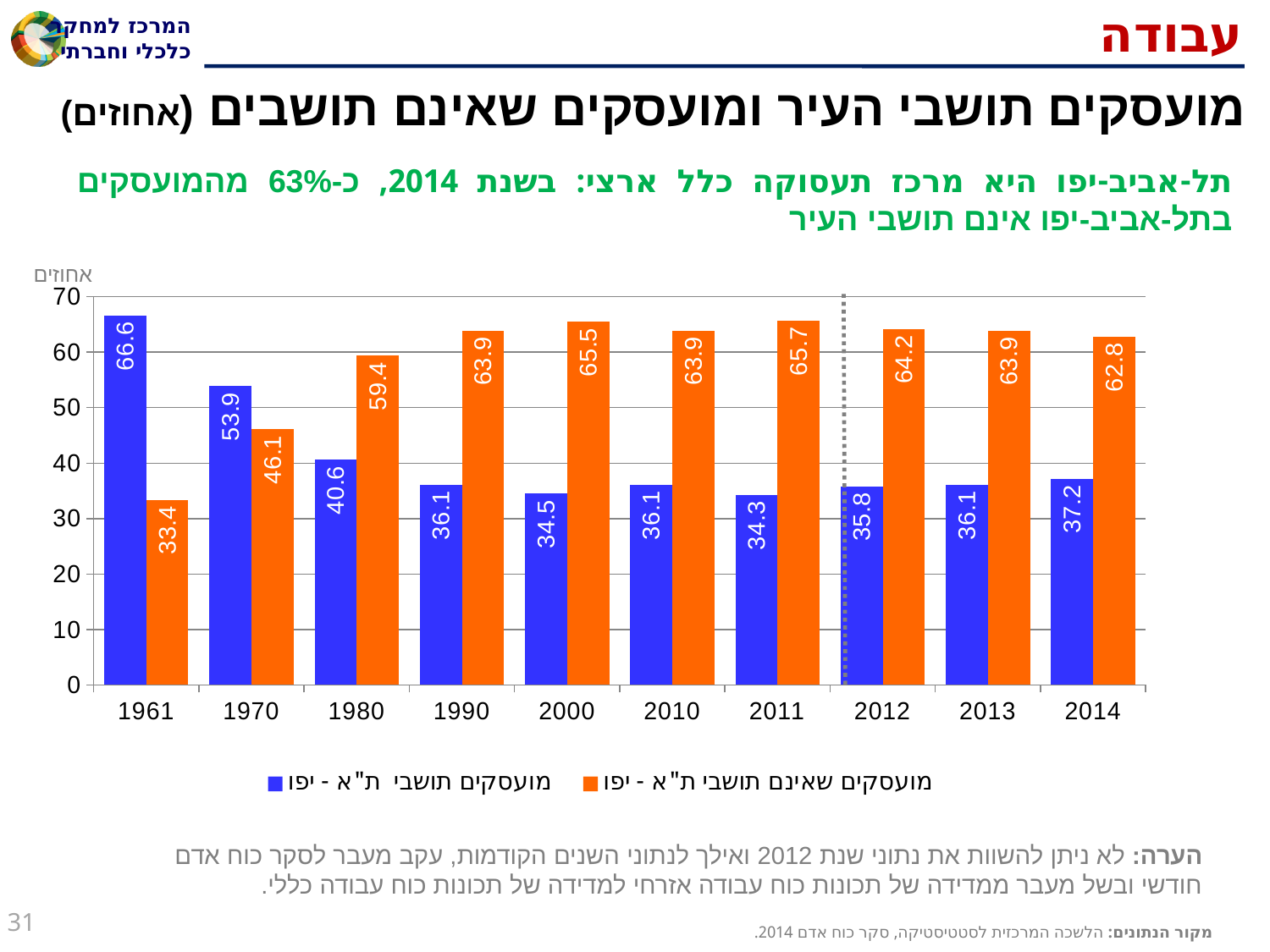
In 1970, which is larger: the value for residents or for non-residents of Tel Aviv-Yafo? residents (53.9) In which year is the value for non-residents of Tel Aviv-Yafo (orange series) highest? 2011 How many series does the legend list? 2 From 1961 to 1990, does the value for residents of Tel Aviv-Yafo (blue series) rise or fall? fall What is the value for non-residents of Tel Aviv-Yafo (מועסקים שאינם תושבי ת"א - יפו) in 2014? 62.8 What kind of chart is shown on the slide? bar chart In which year is the value for residents of Tel Aviv-Yafo (blue series) lowest? 2011 What is the total of the resident and non-resident values in 1961? 100 What is the value for residents of Tel Aviv-Yafo (מועסקים תושבי ת"א - יפו) in 1961? 66.6 What is the value for residents of Tel Aviv-Yafo (מועסקים תושבי ת"א - יפו) in 2000? 34.5 What is the difference between the non-resident and resident values in 2014? 25.6 How many years are shown on the x axis? 10